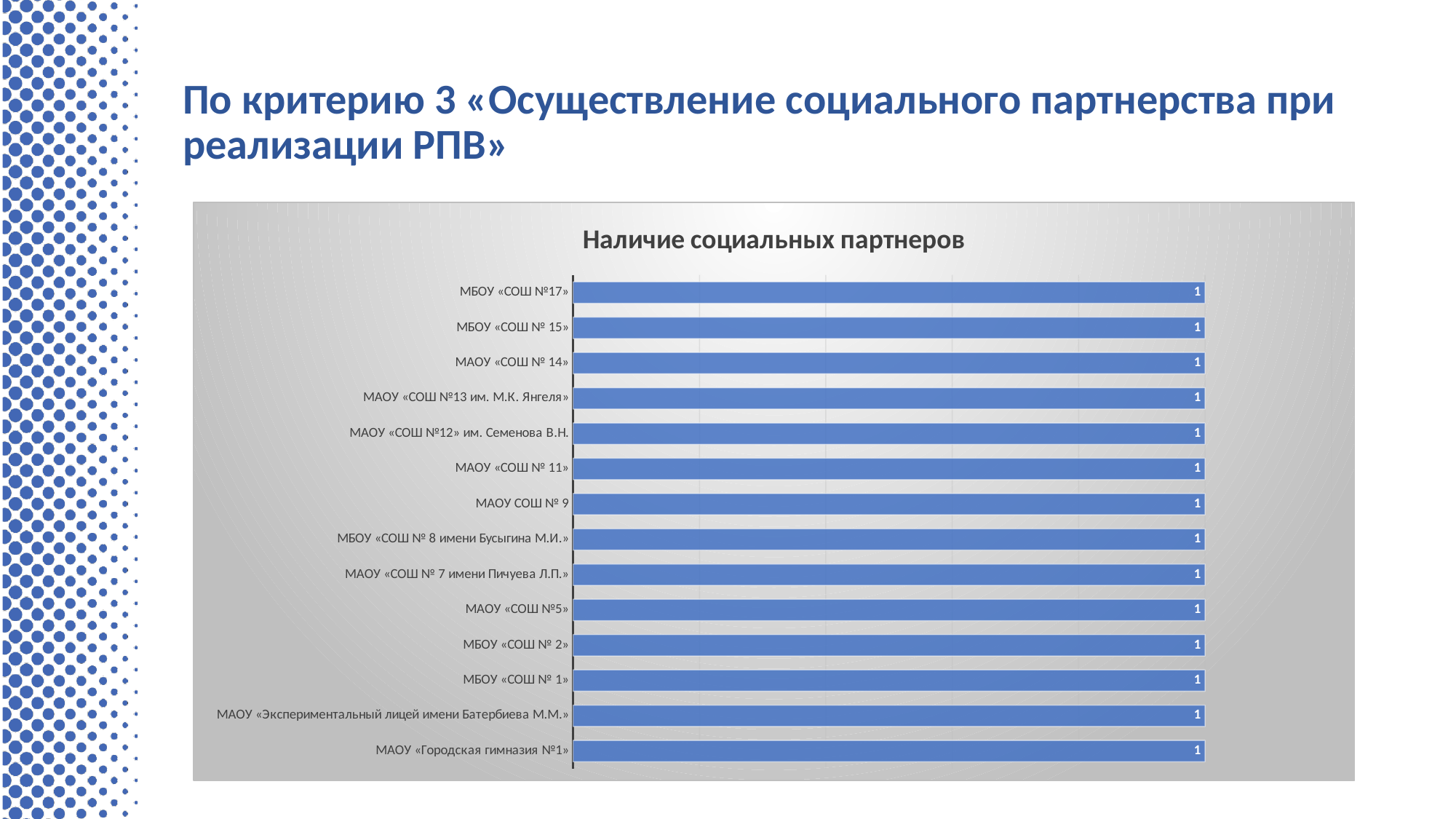
What is the value for МБОУ «СОШ № 8 имени Бусыгина М.И.»? 1 What is the value for МАОУ «Экспериментальный лицей имени Батербиева М.М.»? 1 What is the value for МАОУ «Городская гимназия №1»? 1 What is the value for МБОУ «СОШ №17»? 1 What is the value for МАОУ «СОШ № 7 имени Пичуева Л.П.»? 1 What is the value for МАОУ «СОШ №13 им. М.К. Янгеля»? 1 What is the difference between the values for МБОУ «СОШ № 2» and МБОУ «СОШ № 1»? 0 What is the title of the chart? Наличие социальных партнеров What colour are the bars in the chart? blue What is the value for МАОУ СОШ № 9? 1 What kind of chart is shown on the slide? bar chart How many schools (categories) are shown in the chart? 14